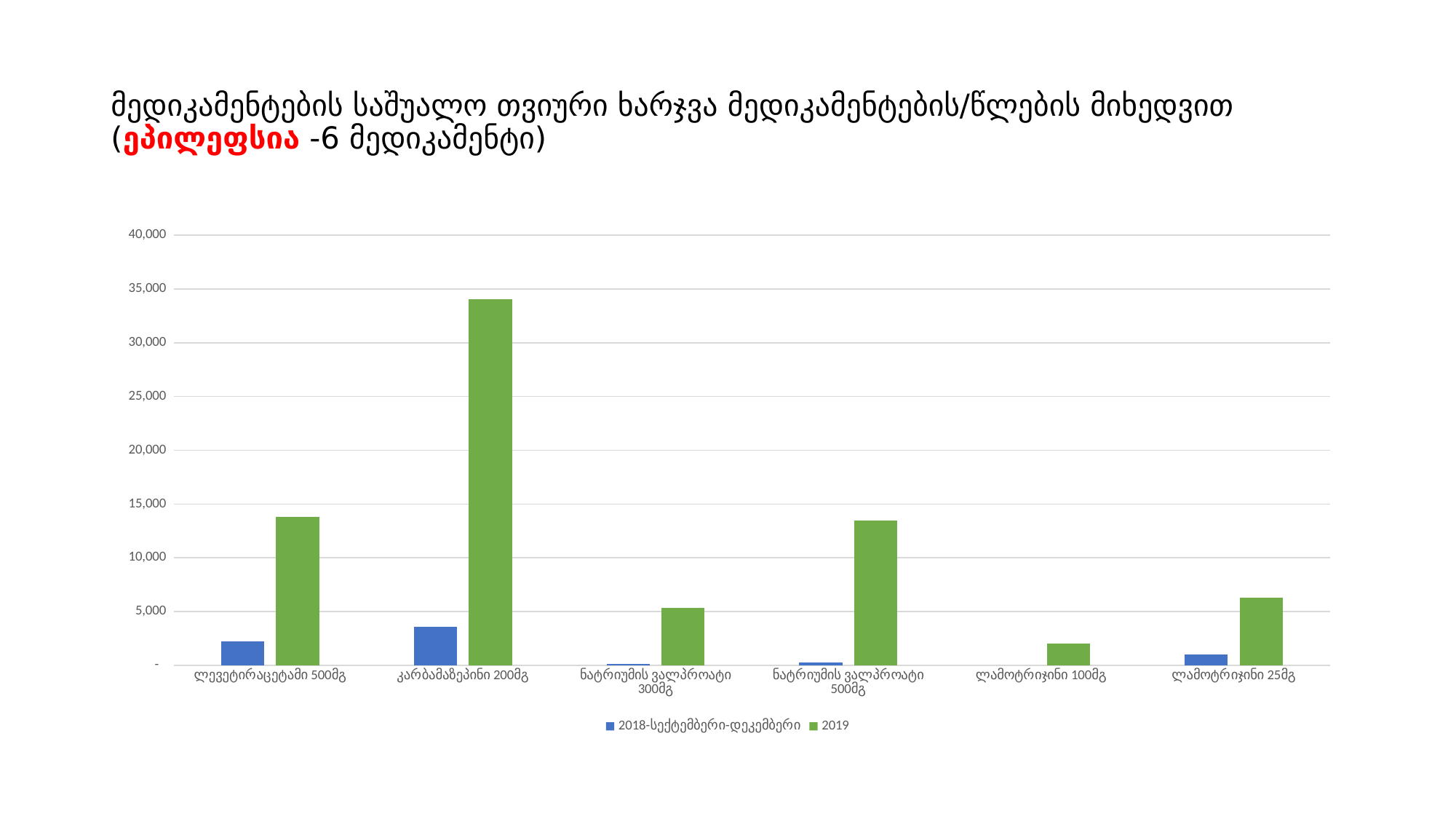
Which category has the highest value for the 2019 series? კარბამაზეპინი 200მგ Is the 2018-სექტემბერი-დეკემბერი value for კარბამაზეპინი 200მგ greater or less than 5,000? less Is the 2019 value for ლევეტირაცეტამი 500მგ greater or less than 15,000? less How many series does the legend list? 2 Is the 2019 value for ლამოტრიჯინი 100მგ greater or less than 5,000? less How many medication categories are shown on the x axis? 6 Which is larger for ლამოტრიჯინი 25მგ: the 2018-სექტემბერი-დეკემბერი value or the 2019 value? 2019 What kind of chart is shown on the slide? bar chart Which category has a larger 2019 value: ნატრიუმის ვალპროატი 300მგ or ნატრიუმის ვალპროატი 500მგ? ნატრიუმის ვალპროატი 500მგ Which category has the highest value for the 2018-სექტემბერი-დეკემბერი series? კარბამაზეპინი 200მგ What colour are the bars for the 2019 series? green